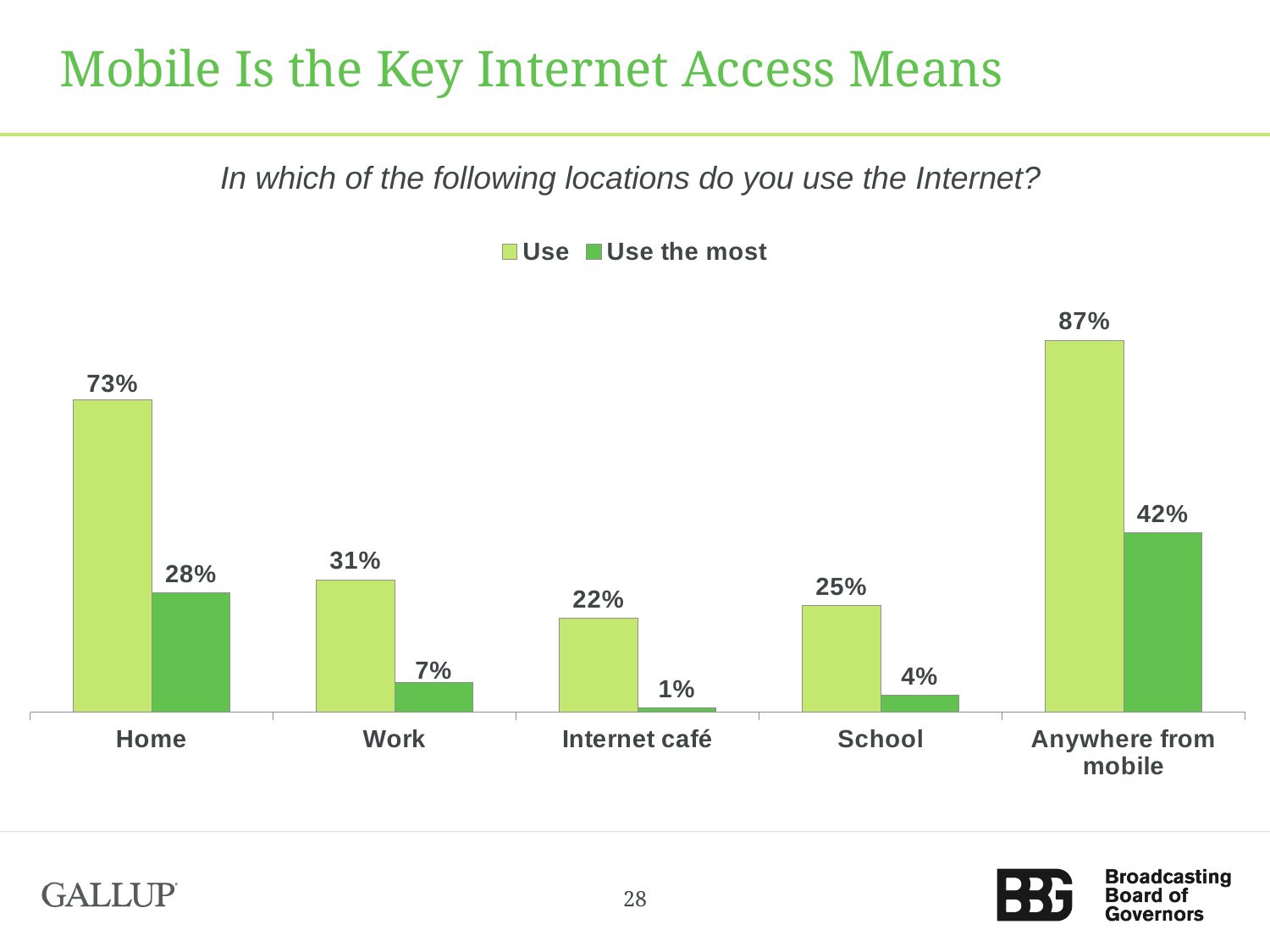
Which location has the highest 'Use' value? Anywhere from mobile Which location has the lowest 'Use the most' value? Internet café How many series does the legend list? 2 What is the difference between the 'Use' values for Anywhere from mobile and Home? 14% What percentage of respondents use the Internet at Home? 73% What is the 'Use the most' value for Internet café? 1% Which is larger, the 'Use' value for Work or the 'Use' value for School? Work How many locations are shown on the x axis? 5 What question is the chart based on, as shown in the subtitle? In which of the following locations do you use the Internet? What kind of chart is shown on the slide? Bar chart What is the difference between the 'Use' and 'Use the most' values for Home? 45% What is the 'Use the most' value for Anywhere from mobile? 42%